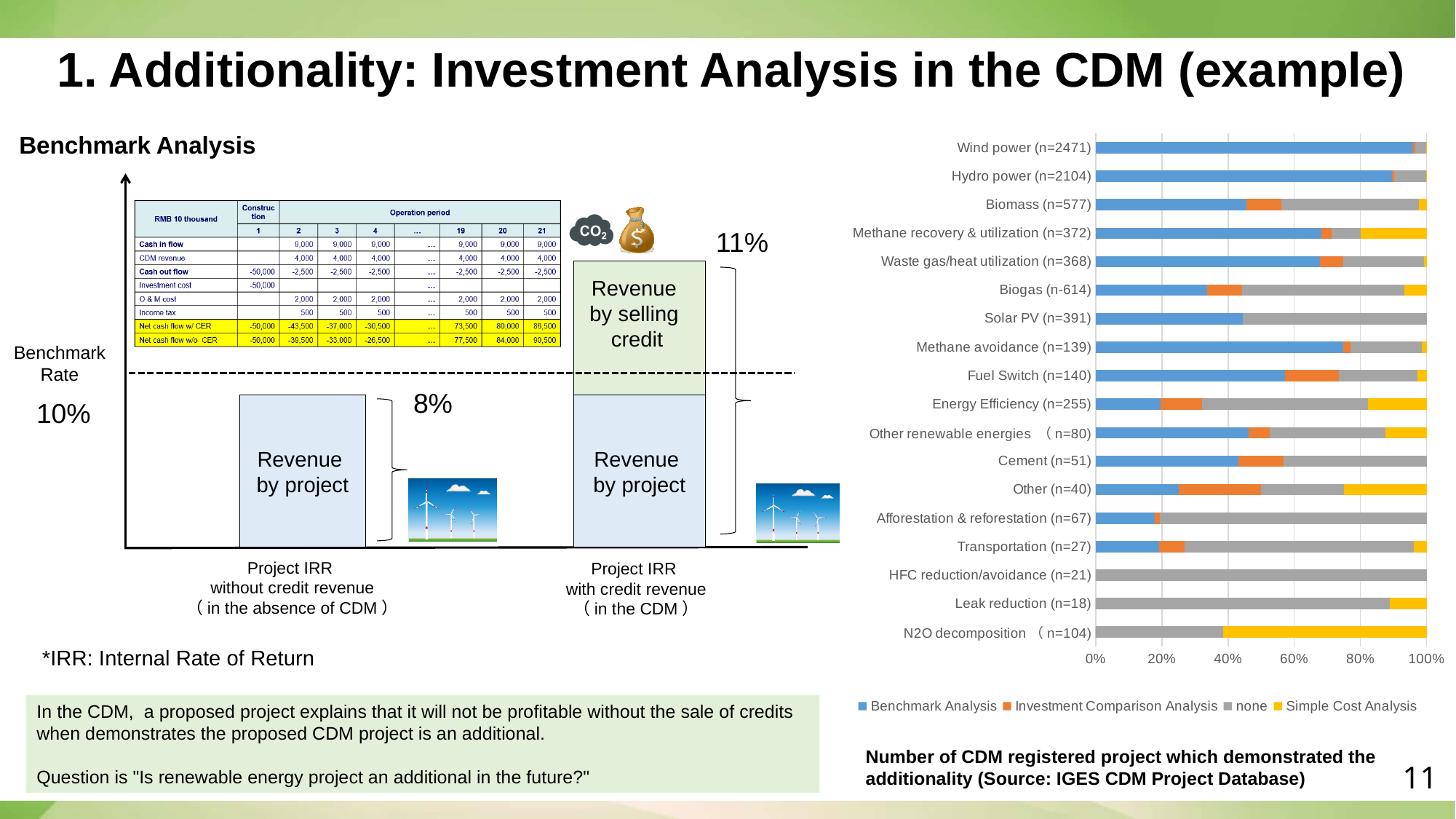
In the bar chart on the right, which category has the largest Simple Cost Analysis share? N2O decomposition (n=104) In the bar chart on the right, which category has the largest Benchmark Analysis share? Wind power (n=2471) In the bar chart on the right, is the Benchmark Analysis share for Solar PV (n=391) greater or less than 40%? greater In the bar chart on the right, which has the larger Benchmark Analysis share: Wind power (n=2471) or Biomass (n=577)? Wind power (n=2471) How many project categories are listed on the bar chart on the right? 18 In the bar chart on the right, is the Benchmark Analysis share for Biogas (n-614) greater or less than 40%? less In the bar chart on the right, which colour represents the 'none' series? Grey What kind of chart is shown on the right side of the slide? Stacked bar chart How many series does the legend of the bar chart on the right list? 4 In the bar chart on the right, which has the larger Investment Comparison Analysis share: Other (n=40) or Wind power (n=2471)? Other (n=40) In the bar chart on the right, is the Simple Cost Analysis share for N2O decomposition (n=104) greater or less than 40%? greater